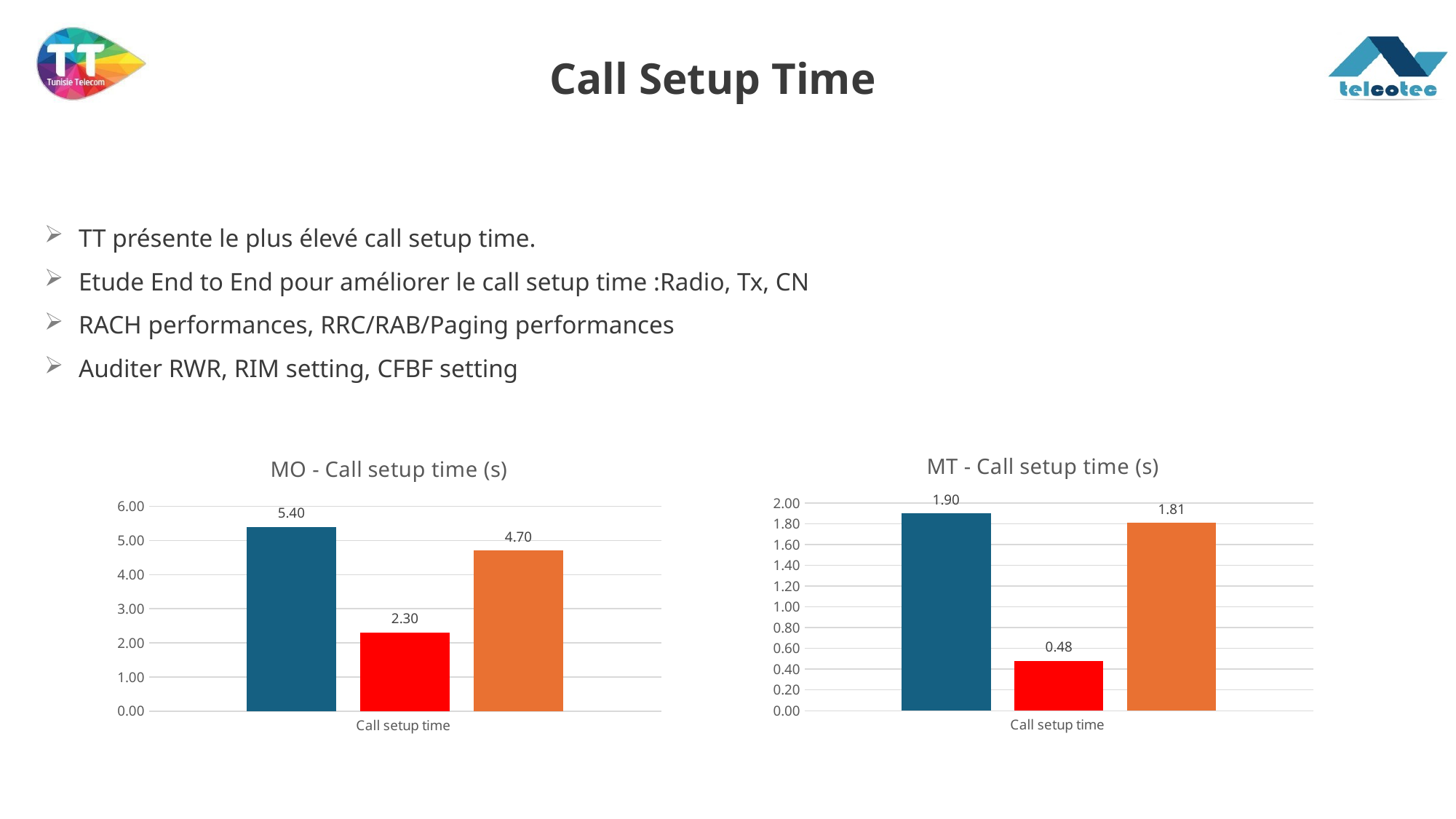
In the 'MT - Call setup time (s)' chart, what is the value of the blue (first) bar? 1.90 In the 'MO - Call setup time (s)' chart, is the orange bar greater or less than 4.00? greater In the 'MO - Call setup time (s)' chart, what is the value of the red (middle) bar? 2.30 In the 'MT - Call setup time (s)' chart, what is the value of the orange (third) bar? 1.81 In the 'MT - Call setup time (s)' chart, what is the value of the red (middle) bar? 0.48 In the 'MO - Call setup time (s)' chart, what is the value of the orange (third) bar? 4.70 What type of chart is the 'MT - Call setup time (s)' chart? Bar chart In the 'MO - Call setup time (s)' chart, what is the value of the blue (first) bar? 5.40 In the 'MT - Call setup time (s)' chart, which bar is the highest? The blue (first) bar In the 'MT - Call setup time (s)' chart, what is the difference between the blue bar and the orange bar? 0.09 In the 'MO - Call setup time (s)' chart, which bar is the lowest? The red (middle) bar In the 'MO - Call setup time (s)' chart, what is the difference between the blue bar and the red bar? 3.10